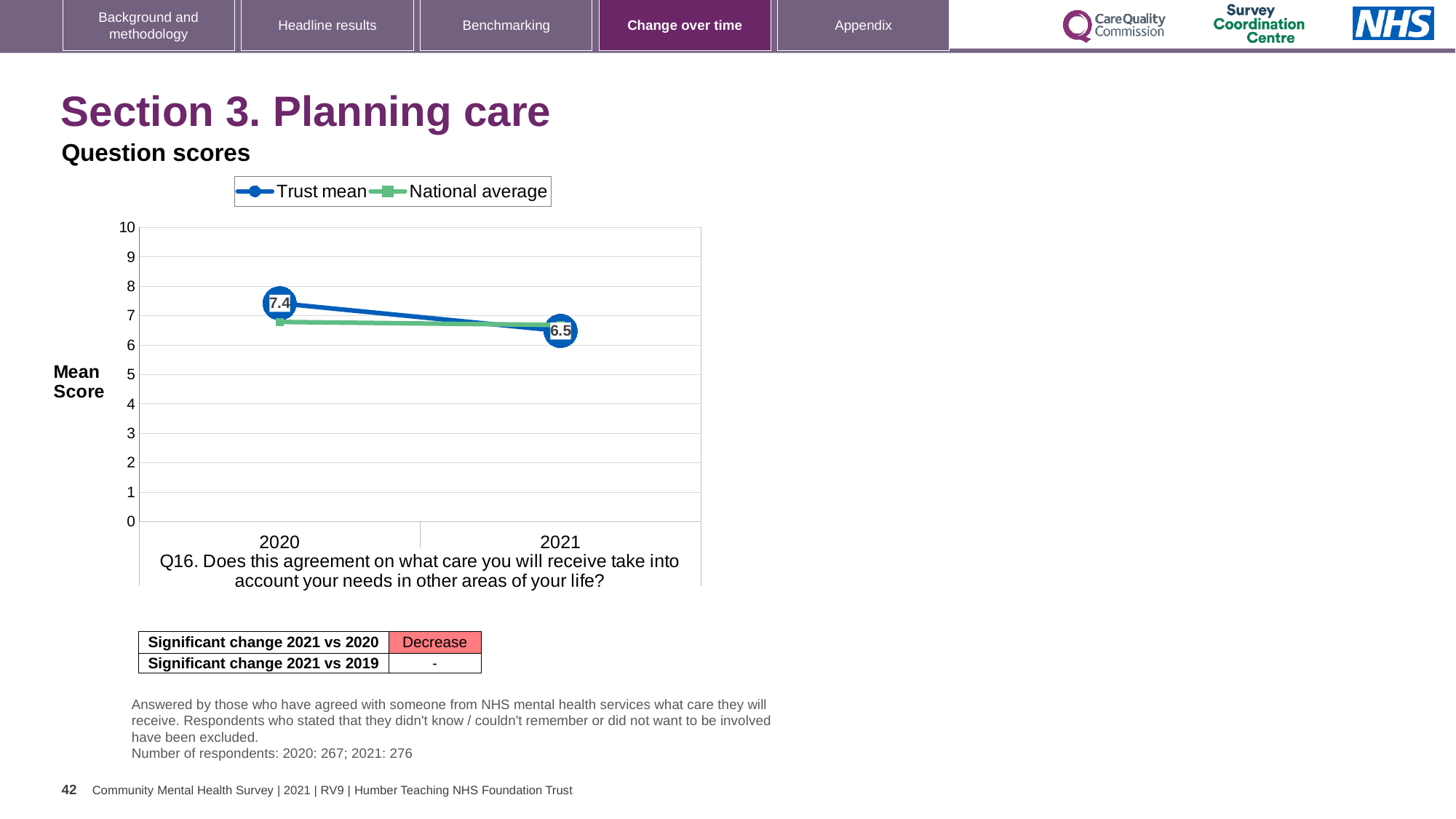
How many years are plotted on the x axis? 2 In 2020, which is larger: the Trust mean or the National average? Trust mean Is the National average value for 2020 greater or less than 6? greater What is the label on the y axis of the chart? Mean Score What is the Trust mean score for 2021? 6.5 In which year is the Trust mean score lowest? 2021 By how much did the Trust mean score change between 2020 and 2021? 0.9 How many series does the legend list? 2 What kind of chart is shown on the slide? line chart What is the Trust mean score for 2020? 7.4 Does the Trust mean rise or fall from 2020 to 2021? fall In which year is the Trust mean score highest? 2020